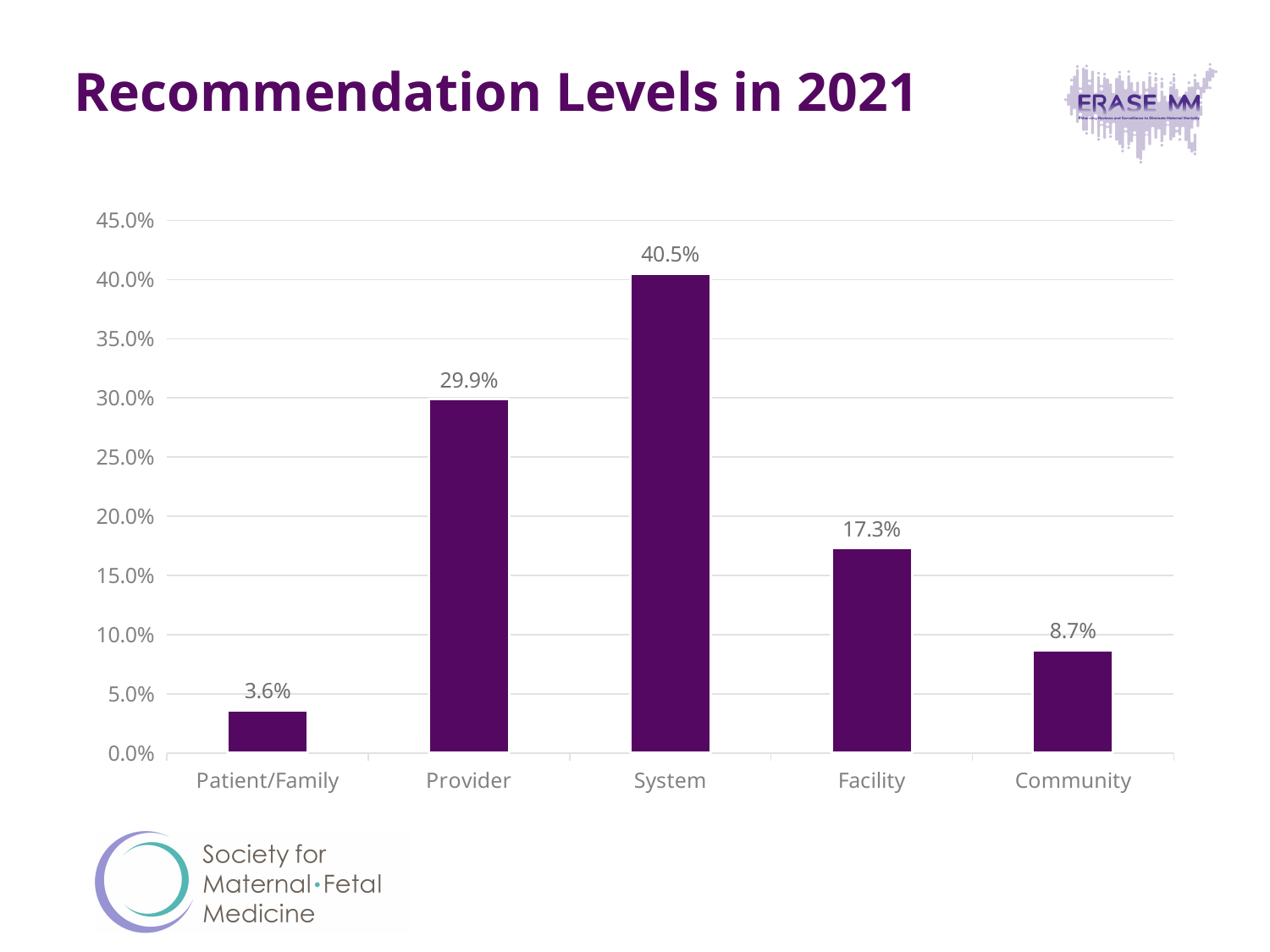
What is the value for Patient/Family? 3.6% What is the value for Community? 8.7% What is the value for System? 40.5% What kind of chart is shown on the slide? bar chart Is the value for Facility greater or less than 20.0%? less What is the difference between the values for Facility and Community? 8.6% Which category has the lowest value? Patient/Family Which category has the highest value? System What is the difference between the values for System and Provider? 10.6% What is the title of the chart? Recommendation Levels in 2021 Which is larger, the value for Provider or the value for Facility? Provider How many categories are shown on the x axis? 5